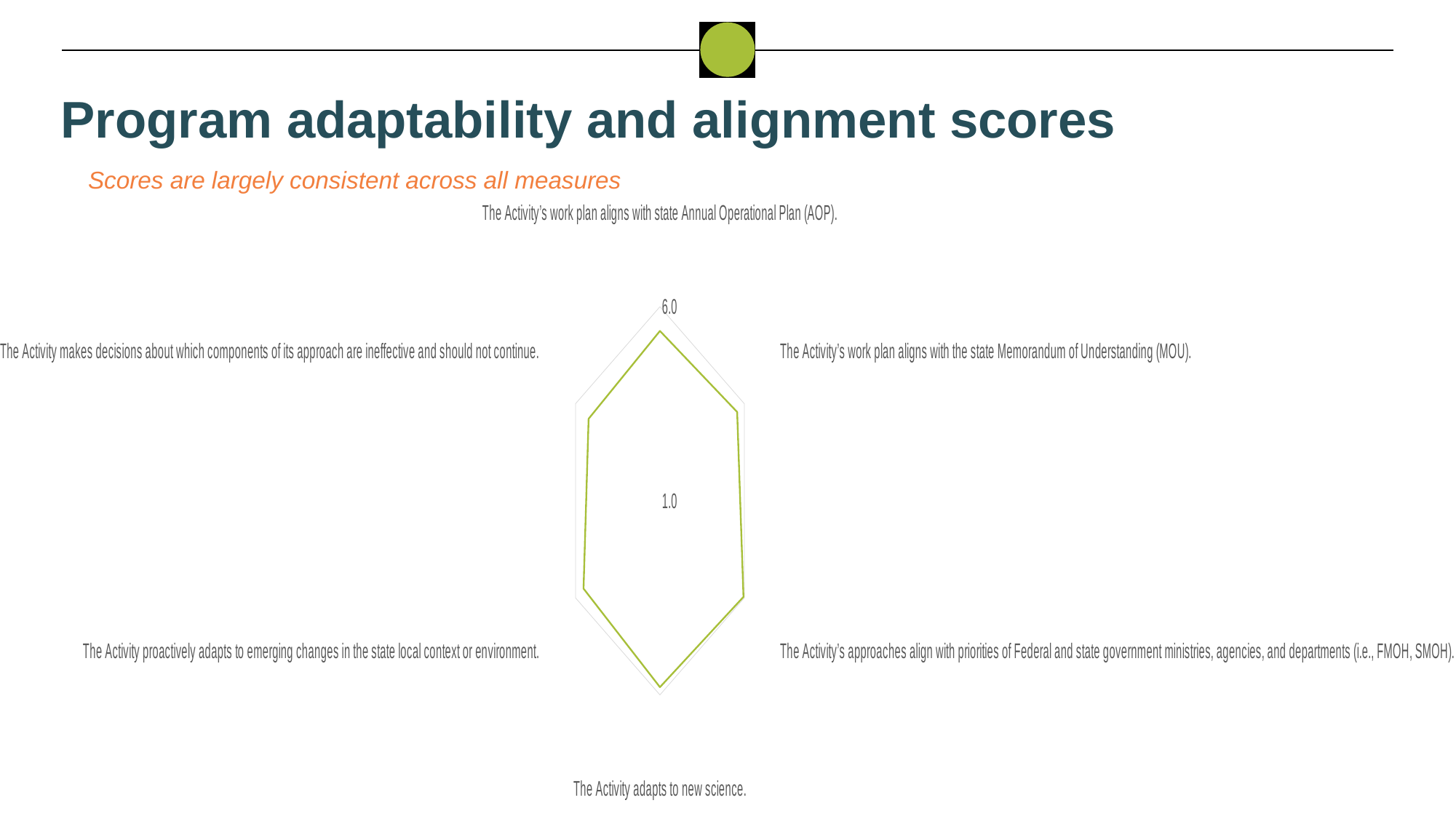
Is the value for "The Activity adapts to new science." greater or less than 1.0? greater Is the value for "The Activity proactively adapts to emerging changes in the state local context or environment." greater or less than 1.0? greater Is the value for "The Activity's work plan aligns with the state Memorandum of Understanding (MOU)." greater or less than 1.0? greater What is the subtitle shown above the radar chart? Scores are largely consistent across all measures How many categories (axes) does the radar chart have? 6 What kind of chart is shown on the slide? Radar chart What is the title of the slide containing the radar chart? Program adaptability and alignment scores What is the highest axis tick value shown on the radar chart? 6.0